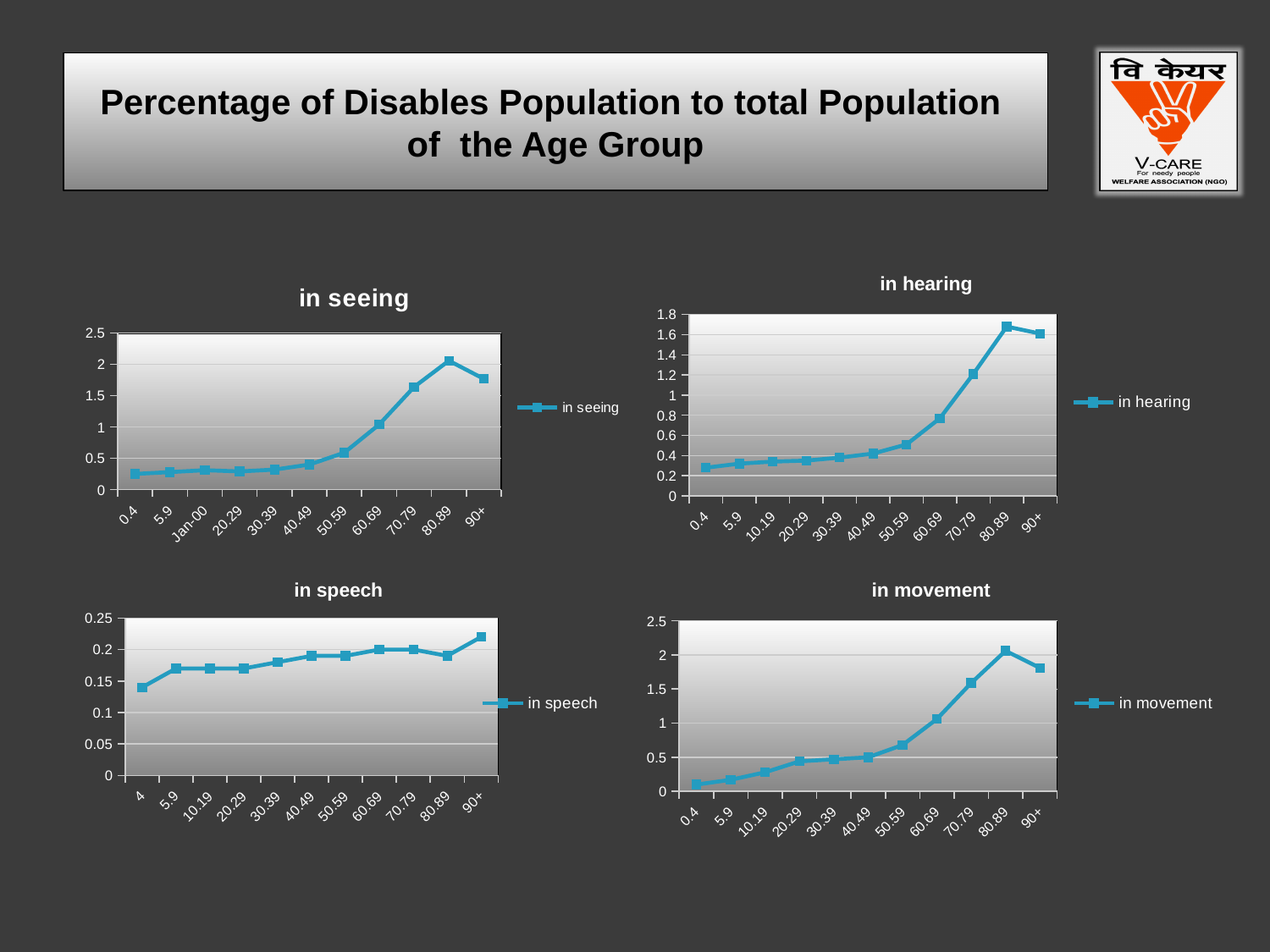
In the 'in hearing' chart, which age group has the lowest value? 0.4 In the 'in speech' chart, do the values generally rise or fall from left to right along the x axis? rise In the 'in speech' chart, which age group has the highest value? 90+ In the 'in seeing' chart, is the value for 70.79 greater or less than 1.5? greater In the 'in seeing' chart, which age group has the highest value? 80.89 What kind of chart is the 'in seeing' chart? line chart In the 'in seeing' chart, which is larger, the value for 80.89 or the value for 90+? 80.89 How many age groups are plotted on the x axis of the 'in hearing' chart? 11 In the 'in hearing' chart, is the value for 70.79 greater or less than 1? greater In the 'in hearing' chart, is the value for 60.69 greater or less than 1? less How many series does the legend of the 'in movement' chart list? 1 In the 'in movement' chart, which age group has the highest value? 80.89